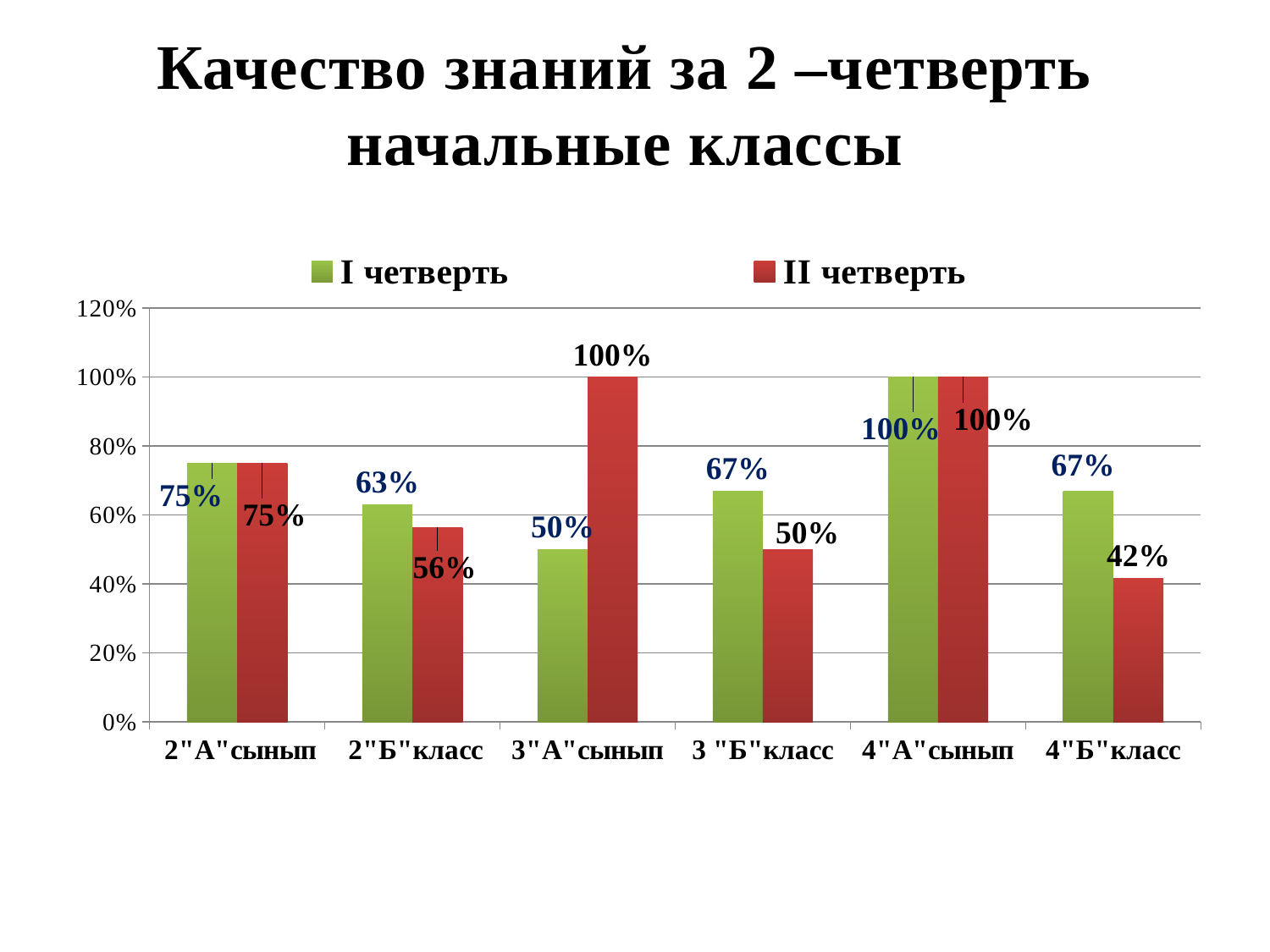
What kind of chart is shown on the slide? bar chart For 3 "Б"класс, which series has the larger value, I четверть or II четверть? I четверть How many categories are shown on the x axis? 6 Which category has the lowest value in the I четверть series? 3"А"сынып What is the value for 4"Б"класс in the II четверть series? 42% Which category has the lowest value in the II четверть series? 4"Б"класс What is the difference between the I четверть and II четверть values for 4"Б"класс? 25% What is the difference between the I четверть and II четверть values for 3"А"сынып? 50% What is the value for 2"Б"класс in the II четверть series? 56% What is the value for 3"А"сынып in the I четверть series? 50% How many series does the legend list? 2 Which colour represents the II четверть series? red